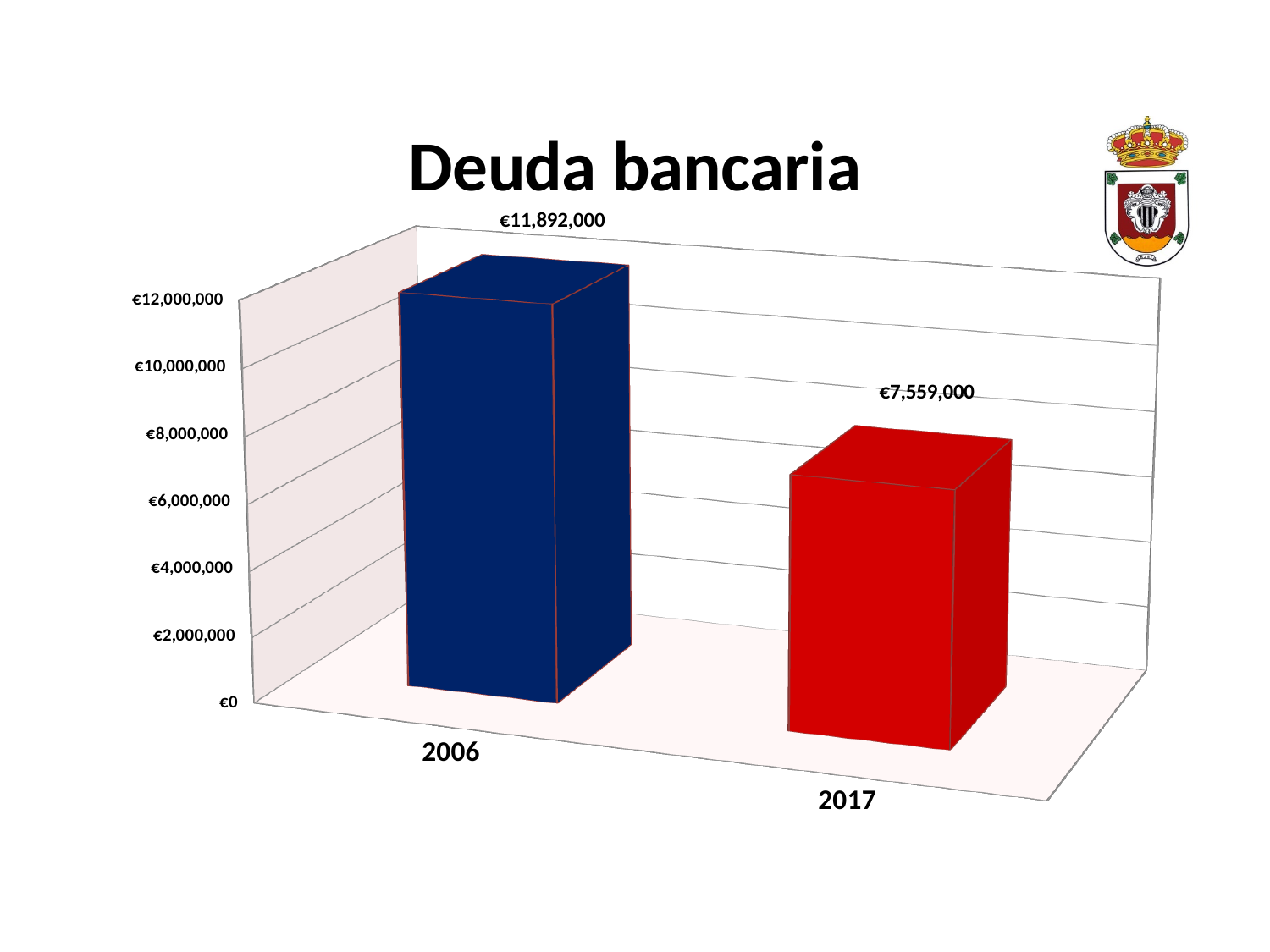
Is the value for 2017 greater or less than €8,000,000? less How many categories are shown on the x axis? 2 What kind of chart is this? bar chart What is the difference between the 2006 and 2017 values? €4,333,000 Is the value for 2006 greater or less than €10,000,000? greater Do the values rise or fall from 2006 to 2017? fall What is the value for 2006? €11,892,000 What is the value for 2017? €7,559,000 Is the value for 2006 larger or smaller than the value for 2017? larger Which year has the higher bank debt? 2006 What is the title of the chart? Deuda bancaria Which year has the lower bank debt? 2017